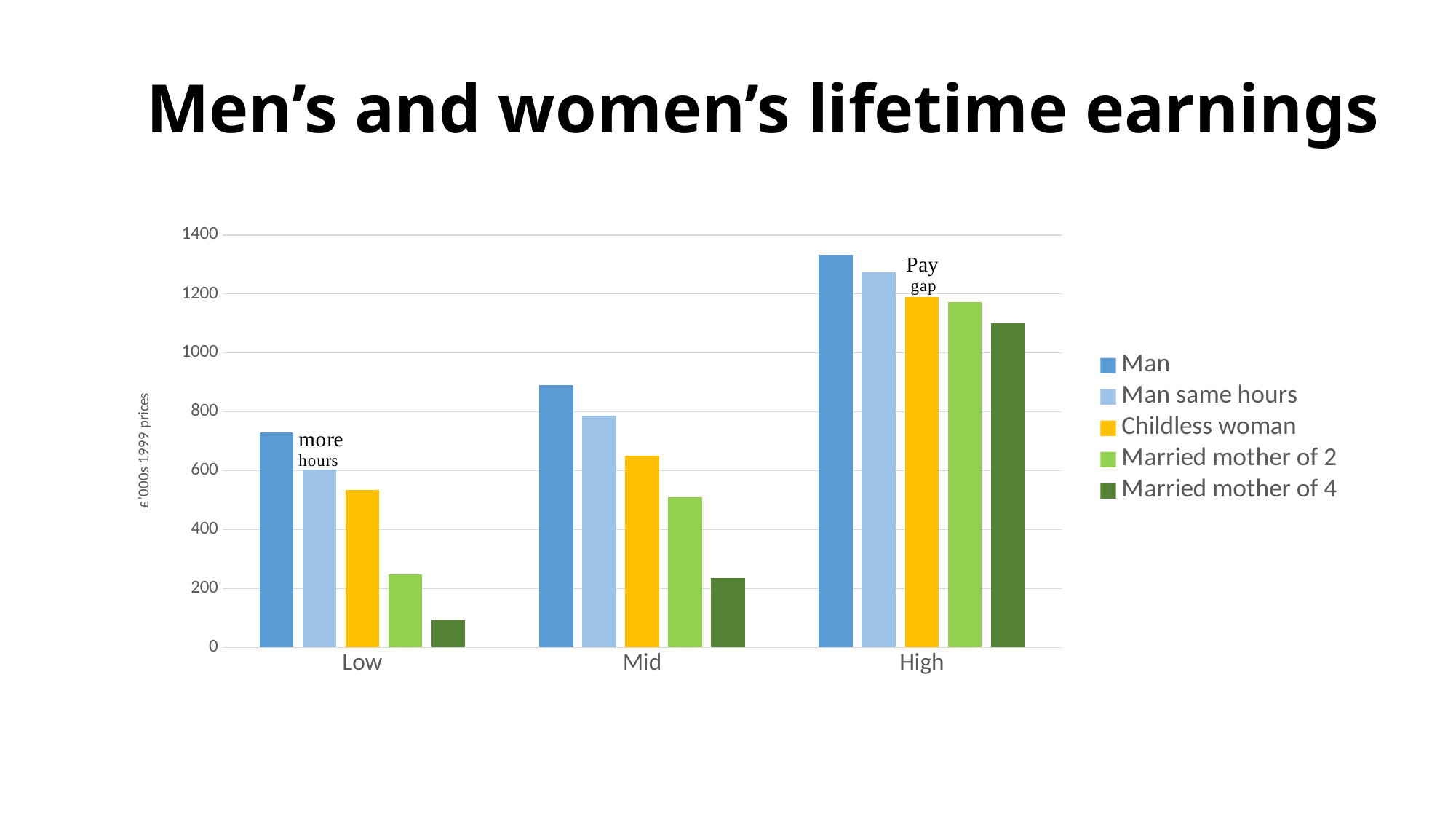
Is the value for Man in the High category greater or less than 1200? greater Do the values for the Man series rise or fall from Low to High? Rise In the Mid category, which is larger: Man or Childless woman? Man What is the label on the y axis? £'000s 1999 prices Is the value for Married mother of 2 in the Mid category greater or less than 400? greater Is the value for Married mother of 4 in the Low category greater or less than 200? less Which series has the lowest value in the Low category? Married mother of 4 How many categories are shown on the x axis? 3 In which category is the Man series highest? High What kind of chart is shown on the slide? Bar chart How many series does the legend list? 5